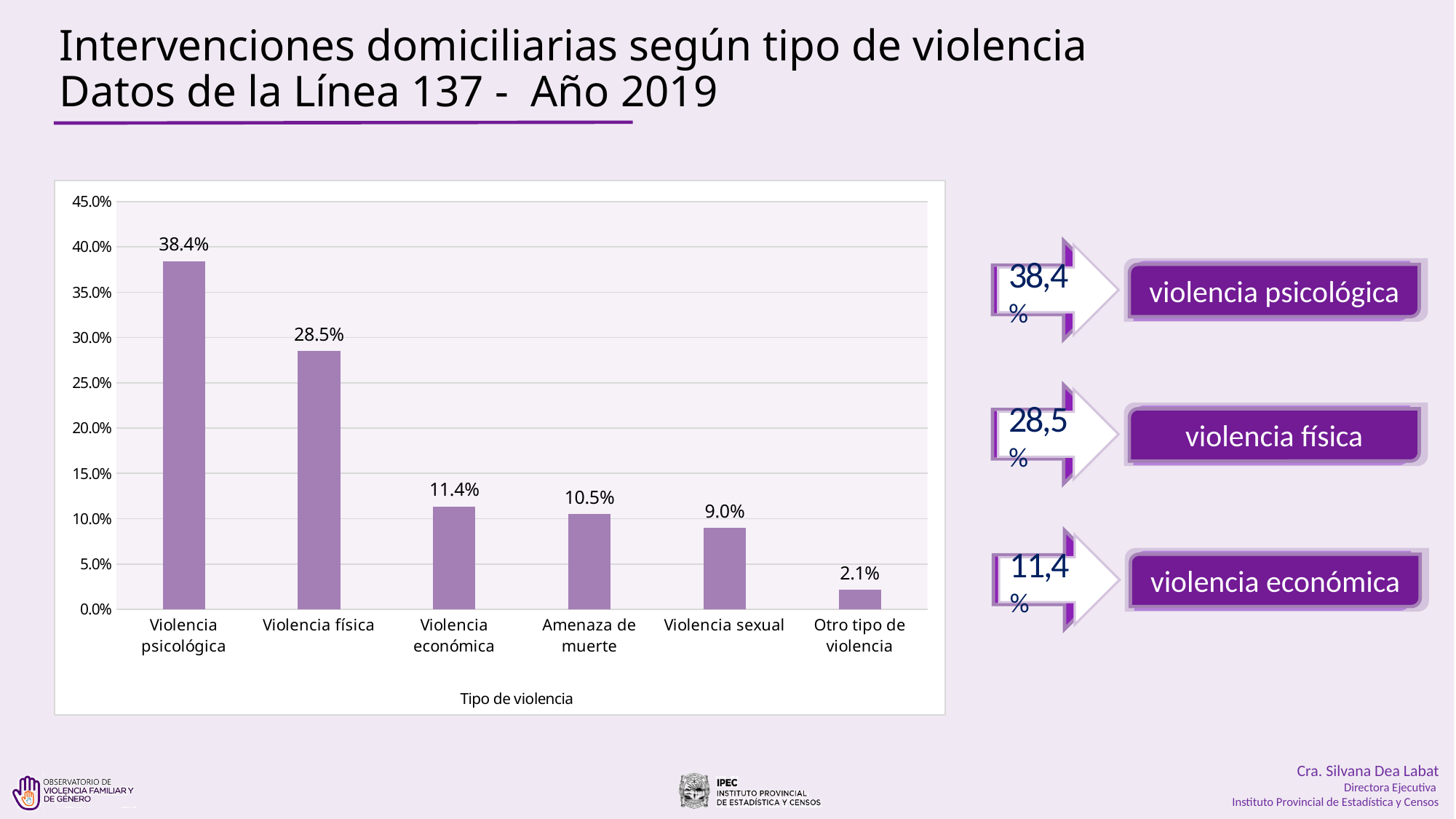
What is the x-axis title of the chart? Tipo de violencia Which is larger, Amenaza de muerte or Violencia sexual? Amenaza de muerte Which type of violence has the highest value? Violencia psicológica What is the value for Otro tipo de violencia? 2.1% What is the value for Amenaza de muerte? 10.5% What is the value for Violencia psicológica? 38.4% Which type of violence has the lowest value? Otro tipo de violencia What kind of chart is shown on the slide? Bar chart Is the value for Violencia física greater or less than 30.0%? less How many types of violence are shown on the x axis? 6 What is the difference between Violencia económica and Violencia sexual? 2.4% What is the difference between Violencia psicológica and Violencia física? 9.9%